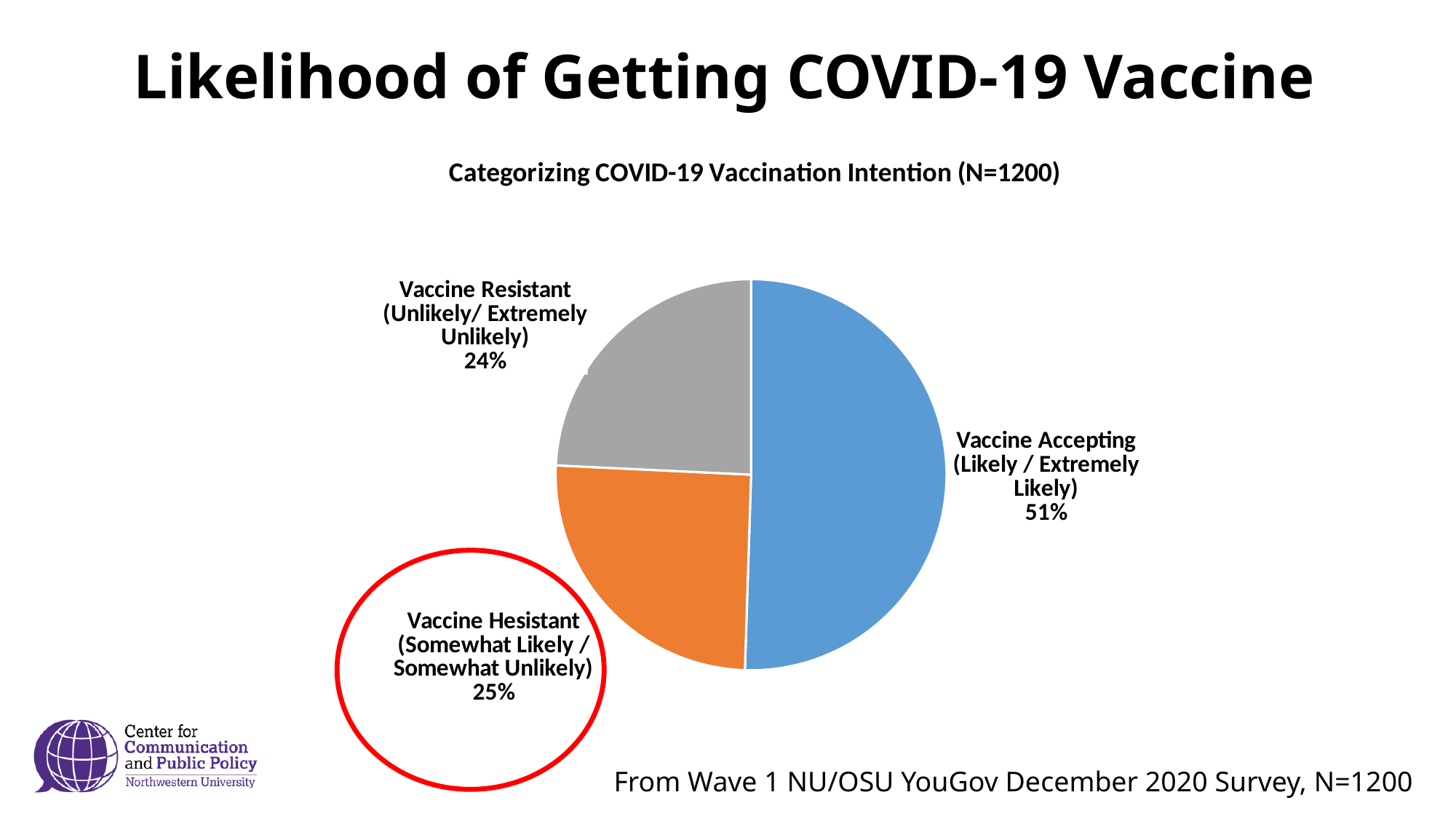
Which is larger, the Vaccine Accepting slice or the Vaccine Hesistant slice? Vaccine Accepting Which category has the largest share of the pie? Vaccine Accepting (Likely / Extremely Likely) What is the combined share of the Vaccine Hesistant and Vaccine Resistant slices? 49% What is the difference in percentage points between the Vaccine Accepting and Vaccine Resistant slices? 27 What colour is the Vaccine Accepting slice? blue What percentage of respondents are Vaccine Resistant (Unlikely / Extremely Unlikely)? 24% What kind of chart is shown on the slide? pie chart What is the title of the chart? Categorizing COVID-19 Vaccination Intention (N=1200) What percentage of respondents are Vaccine Hesistant (Somewhat Likely / Somewhat Unlikely)? 25% What percentage of respondents are Vaccine Accepting (Likely / Extremely Likely)? 51% How many slices does the pie chart have? 3 Which category has the smallest share of the pie? Vaccine Resistant (Unlikely / Extremely Unlikely)